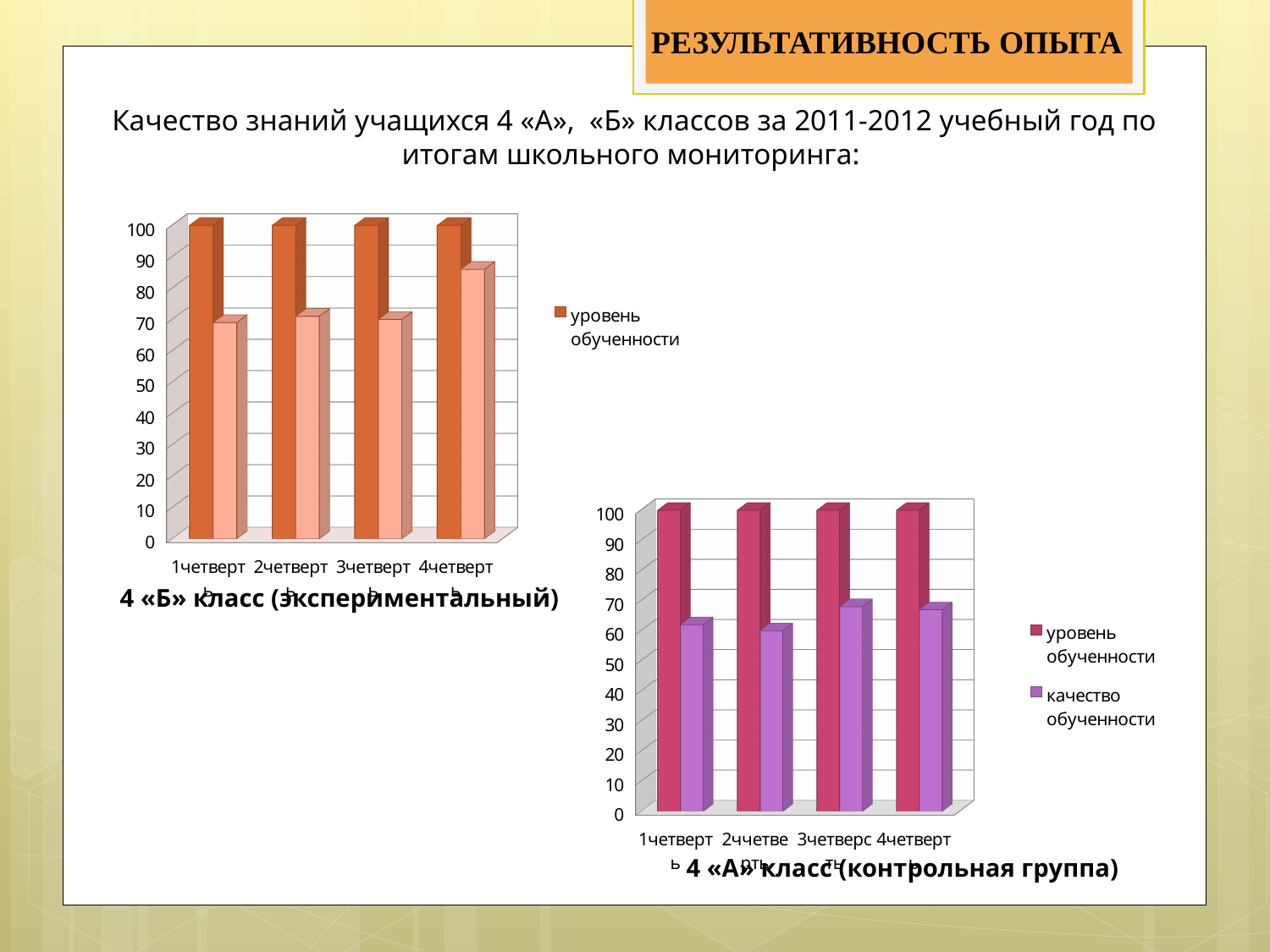
In the chart titled 4 «Б» класс (экспериментальный), is the lighter-coloured bar for 4четверть greater or less than 80? greater In the chart titled 4 «А» класс (контрольная группа), is the value of качество обученности for 1четверть greater or less than 70? less In the chart titled 4 «А» класс (контрольная группа), what is the value of уровень обученности for 1четверть? 100 In the chart titled 4 «Б» класс (экспериментальный), is the value of уровень обученности for 2четверть greater or less than 90? greater In the chart titled 4 «А» класс (контрольная группа), does уровень обученности rise, fall or stay the same across the four quarters? stays the same How many quarters (categories) are shown on the x axis of the chart titled 4 «А» класс (контрольная группа)? 4 In the chart titled 4 «А» класс (контрольная группа), which is larger for качество обученности: 1четверть or 3четверть? 3четверть Which series name is shown in the legend of the chart titled 4 «Б» класс (экспериментальный)? уровень обученности What kind of chart is the chart titled 4 «Б» класс (экспериментальный)? bar chart How many series does the legend of the chart titled 4 «А» класс (контрольная группа) list? 2